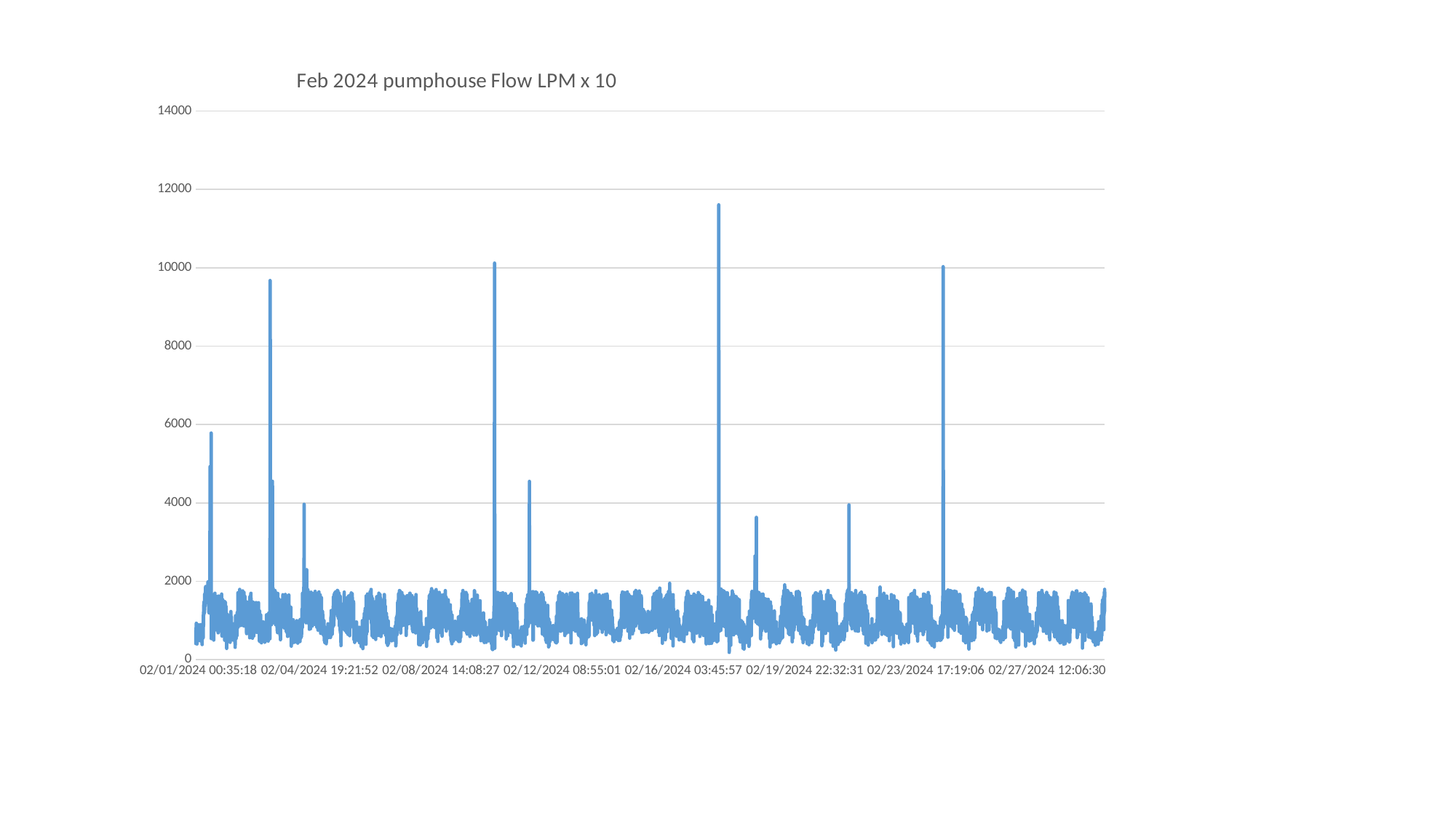
Is the first peak, just after 02/01/2024 00:35:18, greater or less than 6000? less Is the first peak, just after 02/01/2024 00:35:18, greater or less than 4000? greater What is the title of the chart? Feb 2024 pumphouse Flow LPM x 10 Is the highest peak in the chart greater or less than 10000? greater Which is larger: the peak near 02/16/2024 03:45:57 or the peak near 02/23/2024 17:19:06? the peak near 02/16/2024 03:45:57 How many date-time labels are shown along the horizontal axis? 8 What is the first date-time label on the horizontal axis? 02/01/2024 00:35:18 What kind of chart is shown on the slide? line chart What is the highest value labelled on the vertical axis? 14000